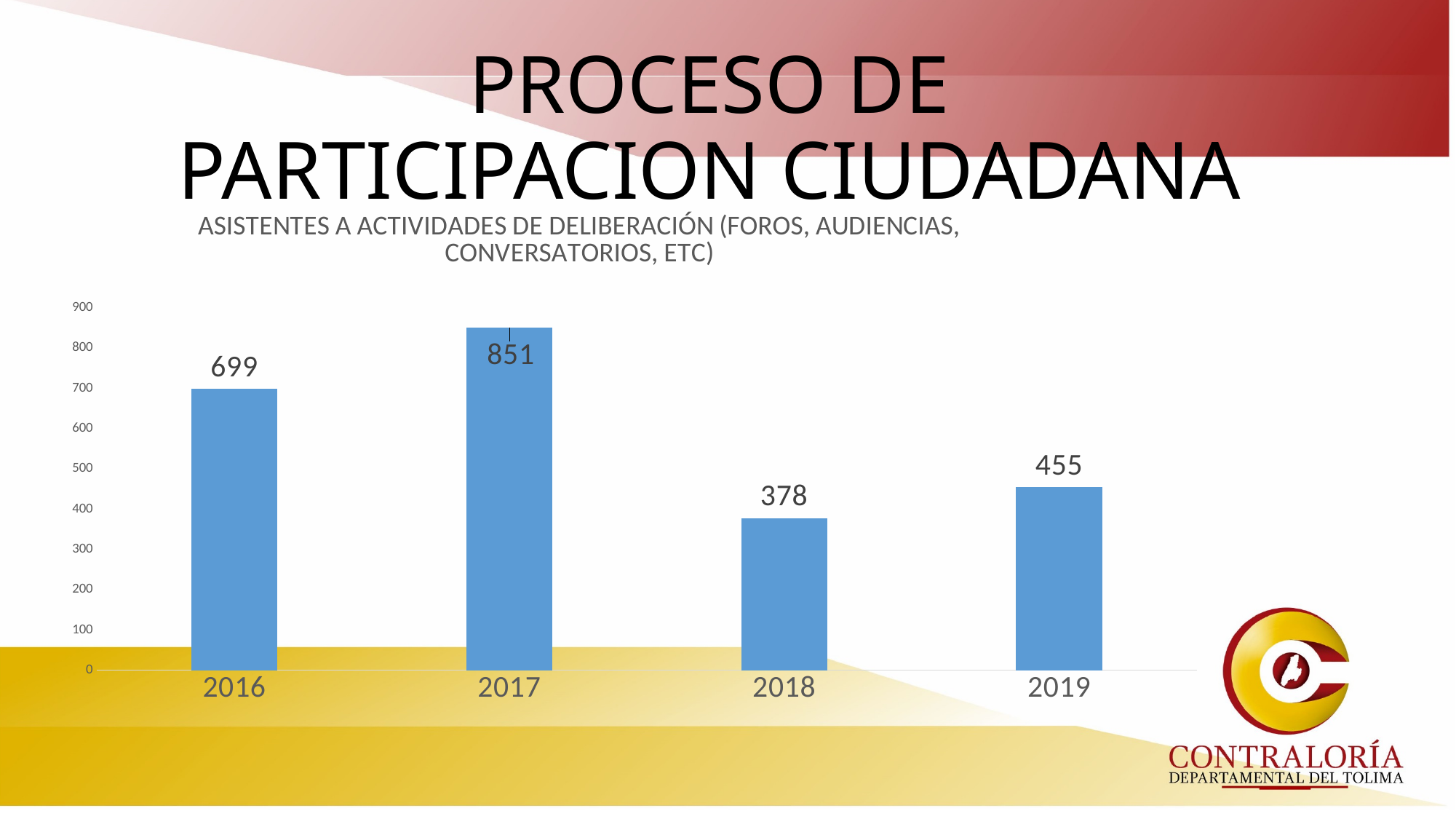
What kind of chart is shown on the slide? Bar chart Which year has the highest value? 2017 What is the value for 2016? 699 How many years are shown on the chart? 4 Do the values rise or fall from 2017 to 2018? Fall What is the value for 2019? 455 What is the difference between the values for 2019 and 2018? 77 What is the value for 2018? 378 What is the value for 2017? 851 What is the difference between the values for 2017 and 2016? 152 Which year has the lowest value? 2018 Which is larger, the value for 2016 or the value for 2019? 2016